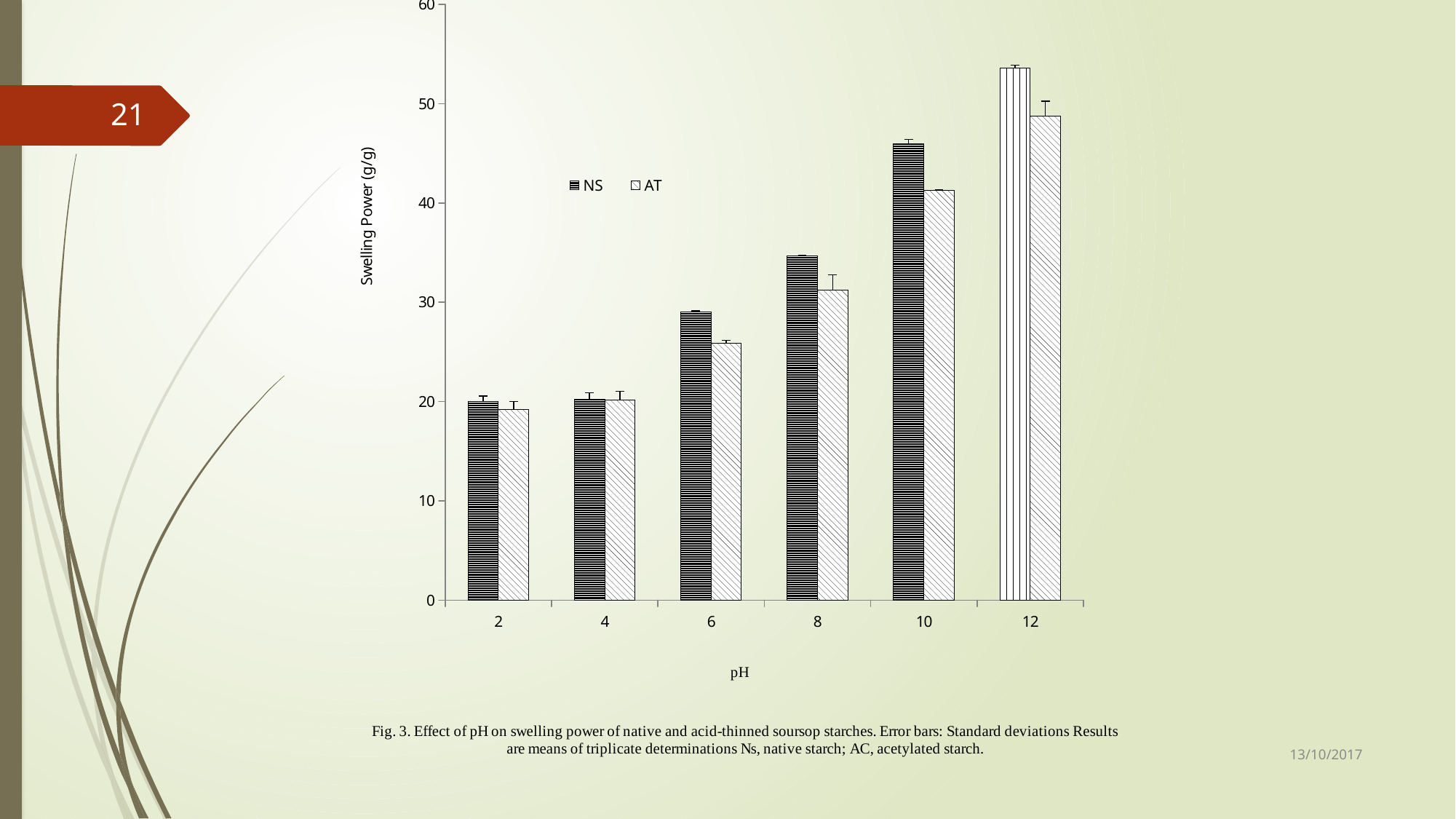
How many series does the legend list? 2 Is the AT value at pH 12 greater or less than 50? less Is the NS value at pH 10 greater or less than 40? greater At pH 8, which series has the larger swelling power, NS or AT? NS At which pH is the NS swelling power highest? 12 At pH 10, which series has the larger swelling power, NS or AT? NS How many pH categories are plotted on the x axis? 6 Is the NS value at pH 12 greater or less than 50? greater What is the label of the y axis? Swelling Power (g/g) Do the NS swelling power values rise or fall as pH increases from 2 to 12? rise What kind of chart is shown on the slide? bar chart At which pH is the AT swelling power highest? 12